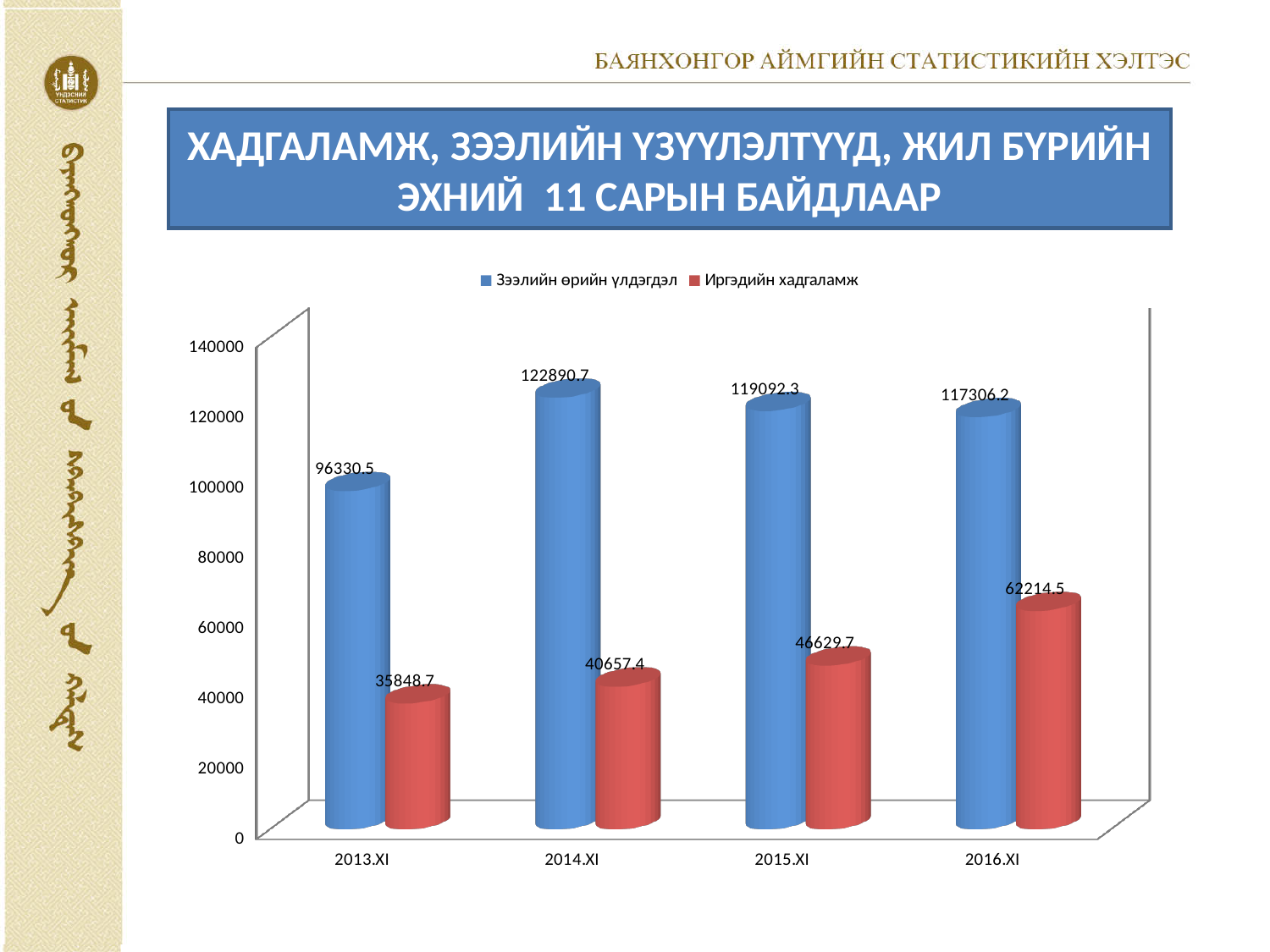
Which is larger: Иргэдийн хадгаламж in 2015.XI or in 2014.XI? 2015.XI What is the difference between Зээлийн өрийн үлдэгдэл and Иргэдийн хадгаламж in 2016.XI? 55091.7 How many periods are shown on the x axis? 4 What is the value of Иргэдийн хадгаламж for 2013.XI? 35848.7 In which period is Зээлийн өрийн үлдэгдэл highest? 2014.XI What is the difference between Зээлийн өрийн үлдэгдэл in 2014.XI and in 2013.XI? 26560.2 Does Иргэдийн хадгаламж rise or fall from 2013.XI to 2016.XI? rise In which period is Иргэдийн хадгаламж lowest? 2013.XI What is the value of Иргэдийн хадгаламж for 2016.XI? 62214.5 What is the value of Зээлийн өрийн үлдэгдэл for 2014.XI? 122890.7 How many series does the legend list? 2 Is the value of Зээлийн өрийн үлдэгдэл for 2013.XI greater or less than 100000? less